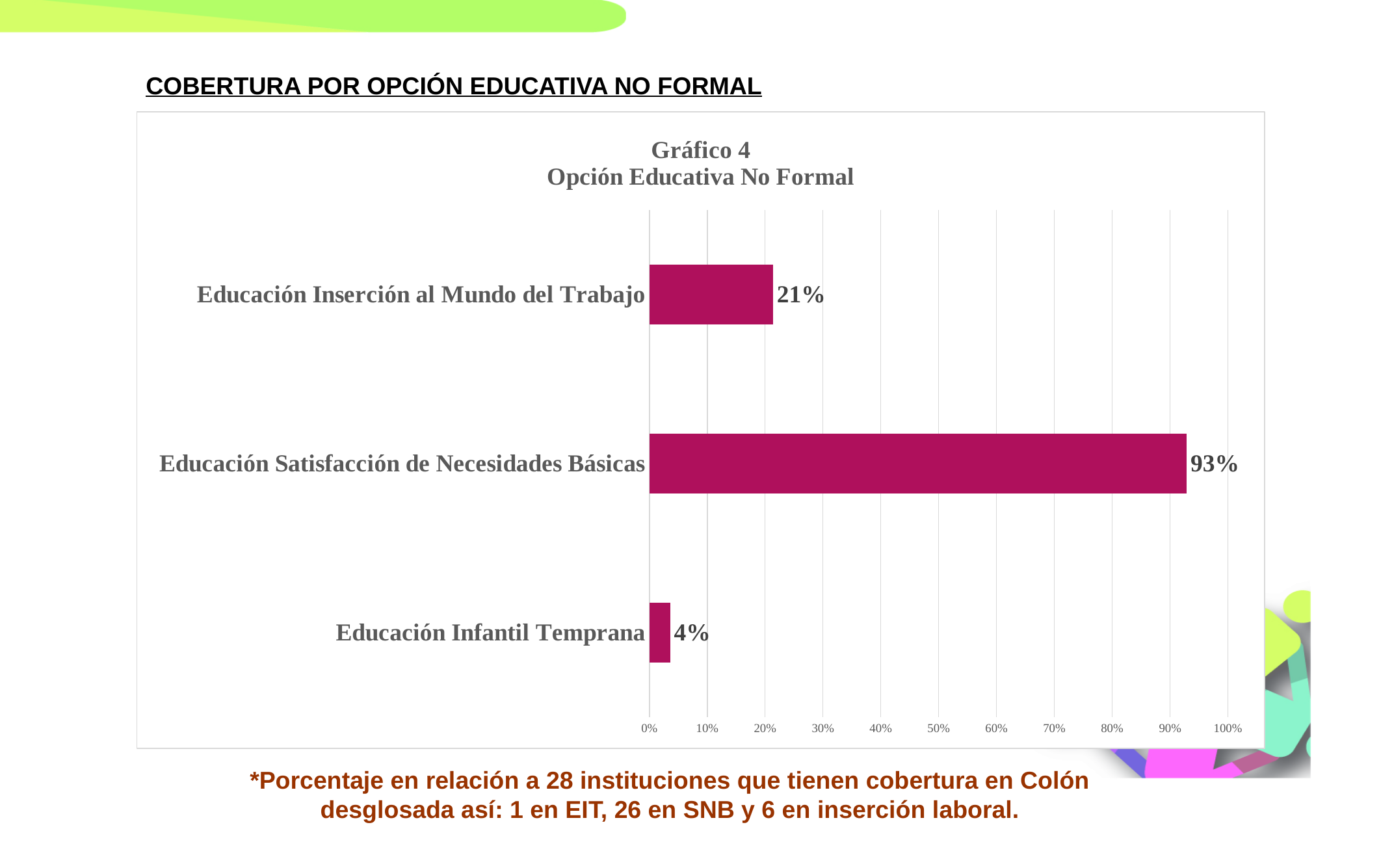
What is the value for Educación Satisfacción de Necesidades Básicas? 93% Which category has the highest value? Educación Satisfacción de Necesidades Básicas What is the difference between the values for Educación Satisfacción de Necesidades Básicas and Educación Inserción al Mundo del Trabajo? 72% What kind of chart is shown on the slide? bar chart What is the difference between the values for Educación Inserción al Mundo del Trabajo and Educación Infantil Temprana? 17% What is the value for Educación Infantil Temprana? 4% What is the title of the chart? Gráfico 4 Opción Educativa No Formal Is the value for Educación Satisfacción de Necesidades Básicas greater or less than 90%? greater How many categories are shown in the chart? 3 What is the value for Educación Inserción al Mundo del Trabajo? 21% Which category has the lowest value? Educación Infantil Temprana Which is larger, the value for Educación Inserción al Mundo del Trabajo or the value for Educación Infantil Temprana? Educación Inserción al Mundo del Trabajo